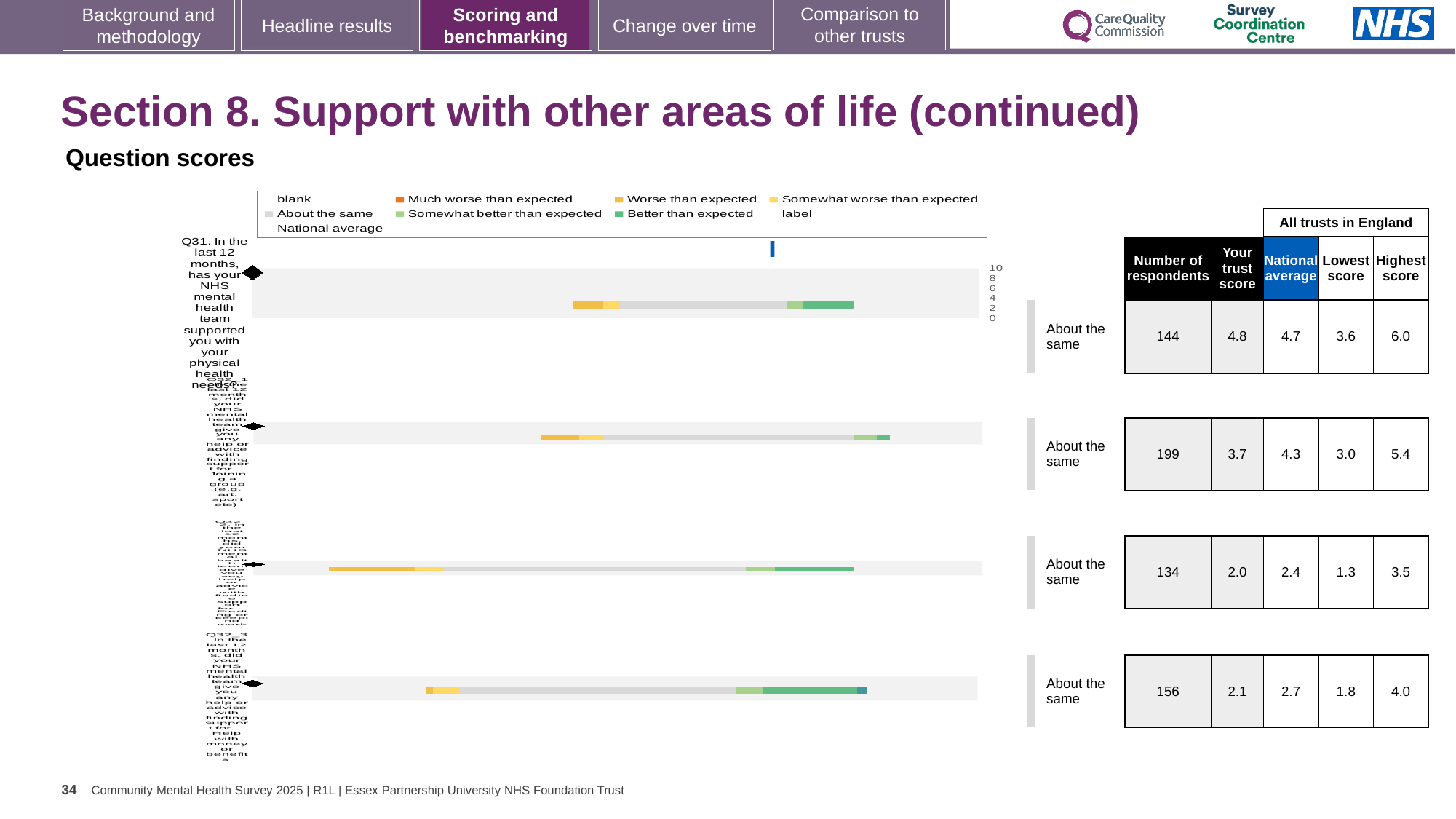
How many entries does the chart legend list? 9 In the table beside the chart, what is 'Your trust score' for the first bar (Q31)? 4.8 In the table beside the chart, is 'Your trust score' for the first bar (Q31) larger or smaller than its national average? larger What is the highest value shown on the chart's axis? 10 In the table beside the chart, which bar has the highest number of respondents? Q32_1 In the table beside the chart, what is the difference between the highest score and the lowest score for the first bar (Q31)? 2.4 Which legend entry is shown in grey in the chart? About the same What kind of chart is shown on the slide? bar chart How many question bars are plotted in the chart? 4 What benchmark label is shown next to each of the four bars? About the same In the table beside the chart, what is the national average for the second bar (Q32_1)? 4.3 In the table beside the chart, what is the number of respondents for the first bar (Q31)? 144